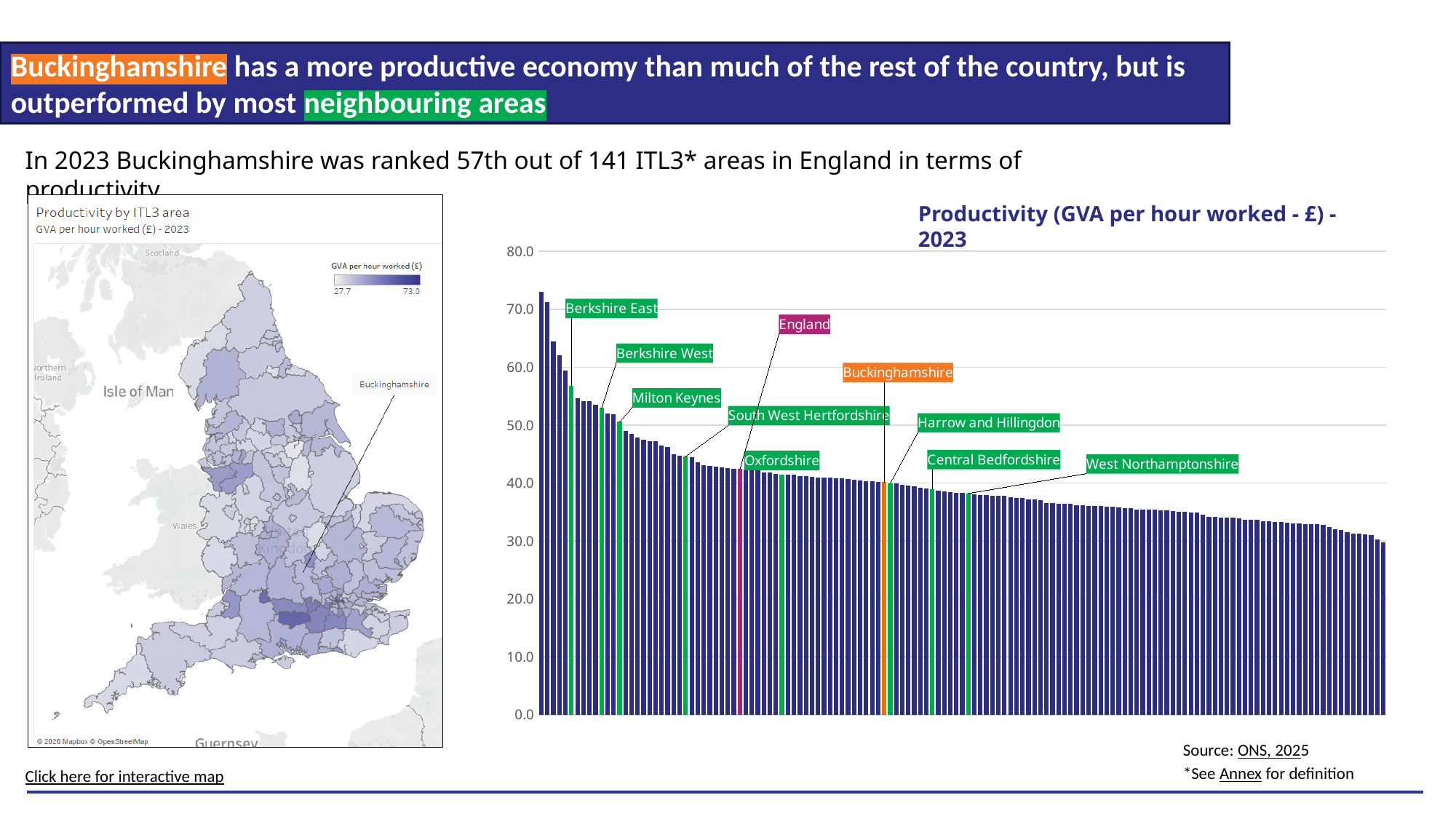
In the 'Productivity (GVA per hour worked - £) - 2023' chart, is the value for Milton Keynes greater or less than 40? greater In the 'Productivity (GVA per hour worked - £) - 2023' chart, which of the labelled areas has the highest value? Berkshire East In the 'Productivity (GVA per hour worked - £) - 2023' chart, is the value for Berkshire East greater or less than 50? greater In the 'Productivity (GVA per hour worked - £) - 2023' chart, is the value for Buckinghamshire greater or less than 50? less What type of chart is the 'Productivity (GVA per hour worked - £) - 2023' chart? bar chart In the 'Productivity (GVA per hour worked - £) - 2023' chart, which is larger: Milton Keynes or West Northamptonshire? Milton Keynes In the 'Productivity (GVA per hour worked - £) - 2023' chart, what colour is the Buckinghamshire bar? orange In the 'Productivity (GVA per hour worked - £) - 2023' chart, which is larger: Berkshire East or Buckinghamshire? Berkshire East In the 'Productivity (GVA per hour worked - £) - 2023' chart, do the values rise or fall from left to right along the x axis? fall In the 'Productivity (GVA per hour worked - £) - 2023' chart, which of the labelled areas has the lowest value? West Northamptonshire